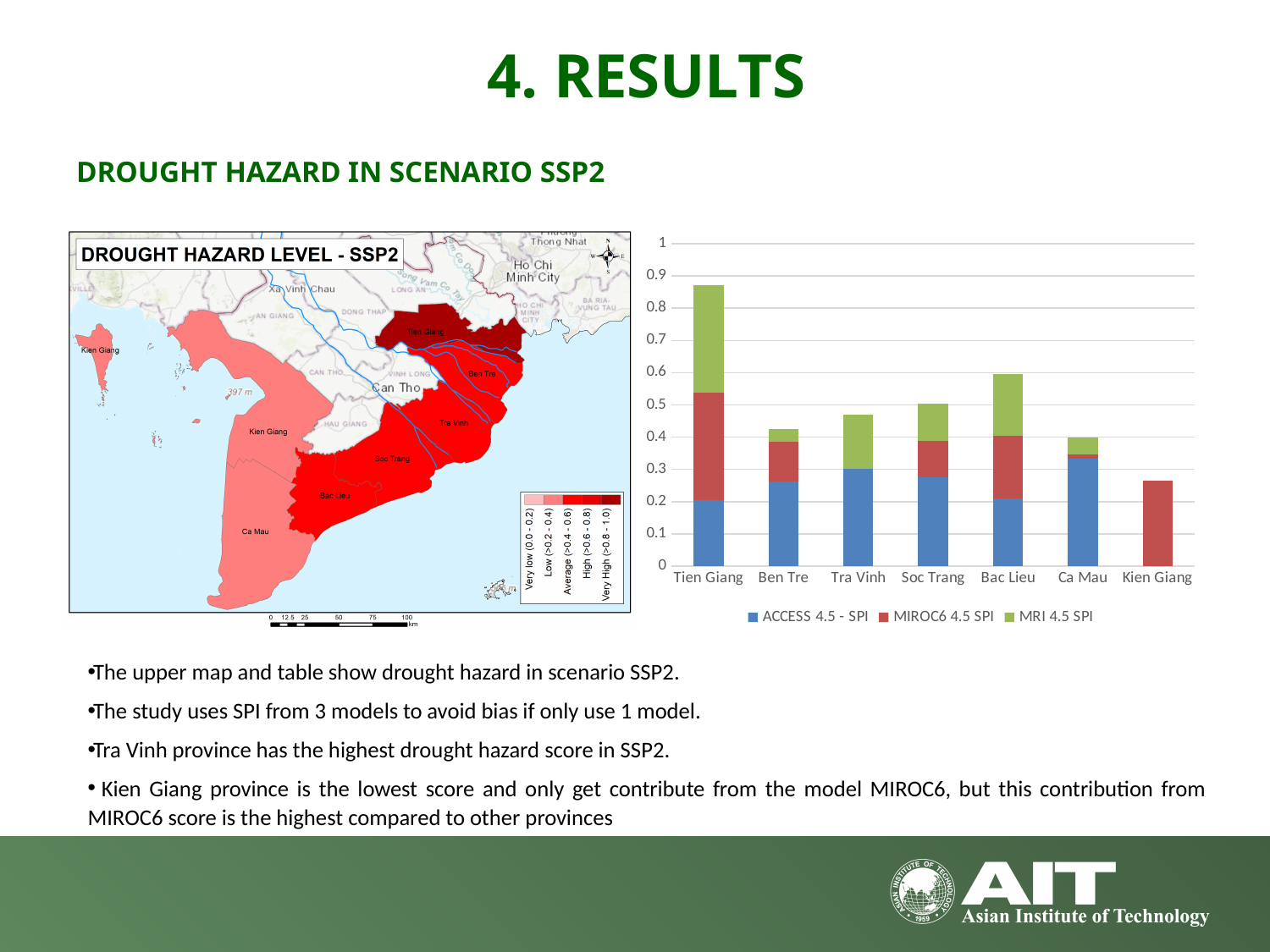
How many series does the legend of the bar chart list? 3 Which series is shown in green in the bar chart legend? MRI 4.5 SPI Is the total stacked value for Bac Lieu greater or less than 0.5? greater What kind of chart is shown on the right of the slide? Stacked bar chart Is the total stacked value for Tien Giang greater or less than 0.8? greater Which province has the shortest stacked bar in the chart? Kien Giang How many provinces are shown on the x axis of the bar chart? 7 Is the total stacked value for Ben Tre greater or less than 0.5? less Which has the larger total stacked value, Bac Lieu or Ben Tre? Bac Lieu Which is the only series that contributes to the Kien Giang bar? MIROC6 4.5 SPI Which province has the tallest stacked bar in the chart? Tien Giang